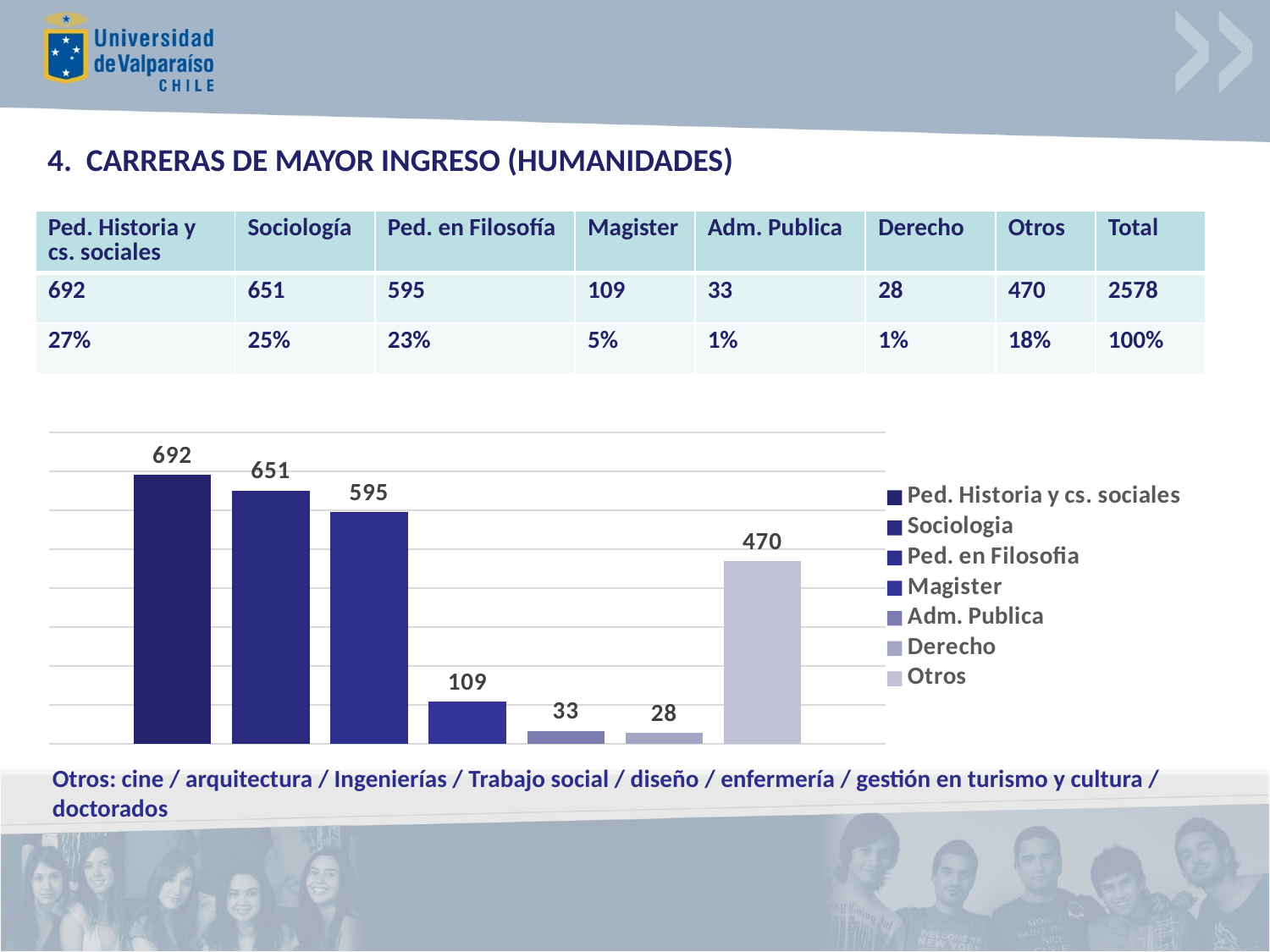
Which is larger, the value for Otros or the value for Ped. en Filosofia? Ped. en Filosofia How many bars are plotted in the chart? 7 How many entries does the chart legend list? 7 What is the difference between the values for Ped. en Filosofia and Magister? 486 What is the value for Adm. Publica in the chart? 33 What is the value for Sociologia in the chart? 651 What is the value for Otros in the chart? 470 What is the value for Ped. Historia y cs. sociales in the chart? 692 What kind of chart is shown on the slide? Bar chart What is the difference between the values for Ped. Historia y cs. sociales and Sociologia? 41 Which category has the lowest value in the chart? Derecho Which category has the highest value in the chart? Ped. Historia y cs. sociales